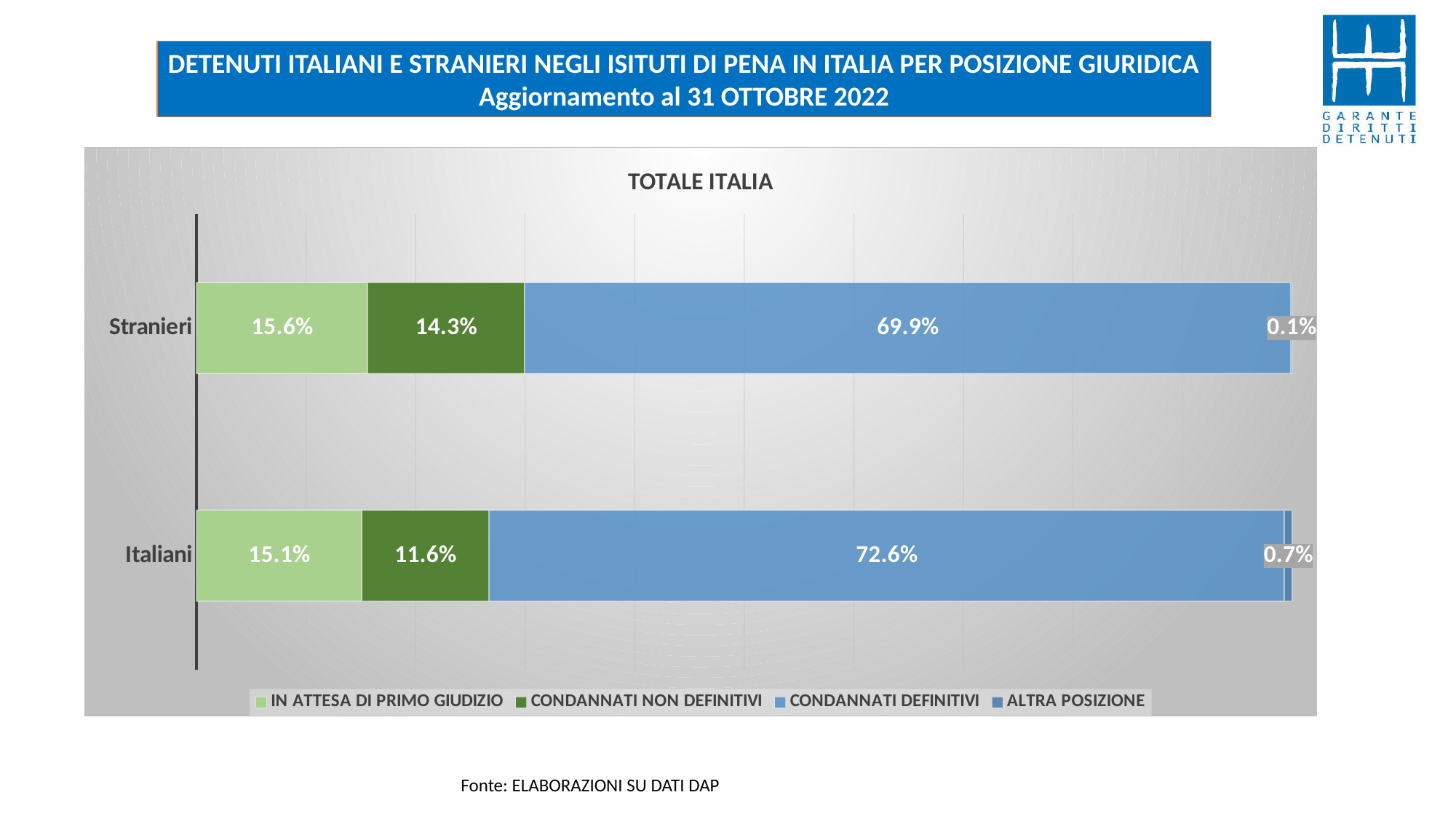
Which legal position has the largest share among Stranieri? CONDANNATI DEFINITIVI Which category has the higher CONDANNATI NON DEFINITIVI share, Stranieri or Italiani? Stranieri What percentage of Italiani are IN ATTESA DI PRIMO GIUDIZIO? 15.1% What percentage of Stranieri are CONDANNATI DEFINITIVI? 69.9% What is the CONDANNATI NON DEFINITIVI value for Stranieri? 14.3% What is the difference between the CONDANNATI NON DEFINITIVI shares of Stranieri and Italiani? 2.7% What is the ALTRA POSIZIONE value for Italiani? 0.7% Which legal position has the smallest share among Italiani? ALTRA POSIZIONE What is the difference between the CONDANNATI DEFINITIVI shares of Italiani and Stranieri? 2.7% What kind of chart is shown on the slide? Stacked bar chart Which category has the higher CONDANNATI DEFINITIVI share, Stranieri or Italiani? Italiani How many series does the legend list? 4